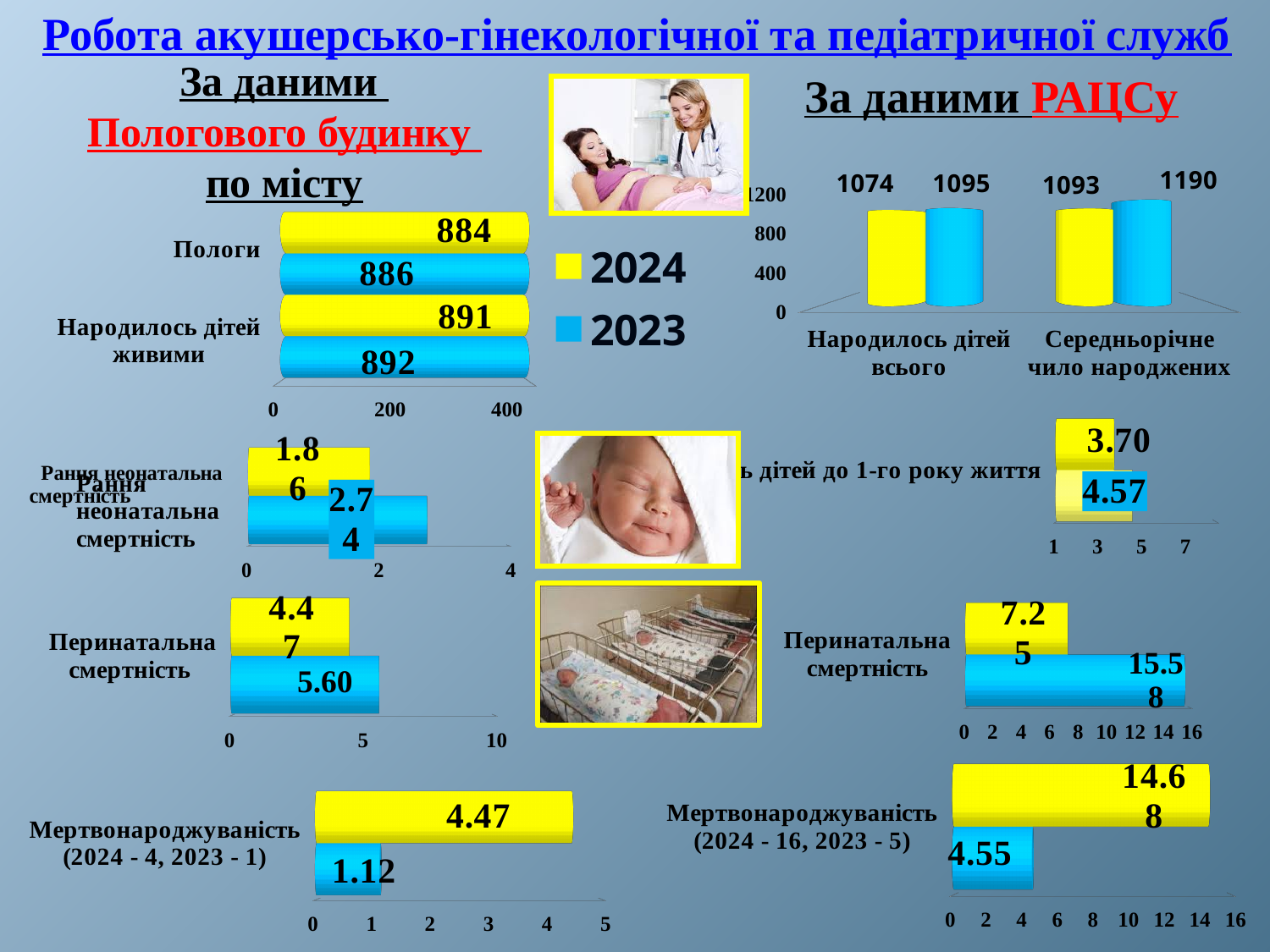
In the РАЦС chart (top right, vertical bars), which bar is the highest? Середньорічне число народжених, 2023 (1190) In the chart for Смертність дітей до 1-го року життя (right side, middle), which year has the larger value, 2024 or 2023? 2023 In the maternity hospital chart (top left), what is the difference between Пологи in 2023 and Пологи in 2024? 2 In the РАЦС chart (top right, vertical bars), what is the difference between Середньорічне число народжених in 2023 and in 2024? 97 In the chart for Смертність дітей до 1-го року життя (right side, middle), what is the value for 2024? 3.70 In the maternity hospital chart (top left), what is the value for Народилось дітей живими in 2023? 892 According to the legend in the centre of the slide, which colour represents 2023? Blue In the РАЦС chart (top right, vertical bars), what is the value for Народилось дітей всього in 2023? 1095 In the Мертвонароджуваність chart on the left (2024 - 4, 2023 - 1), what is the difference between the 2024 and 2023 values? 3.35 In the РАЦС chart (top right, vertical bars), is the value for Народилось дітей всього in 2024 greater or less than 800? greater In the maternity hospital chart (top left, 'Пологи' and 'Народилось дітей живими'), what is the value for Пологи in 2024? 884 In the Перинатальна смертність chart on the left (maternity hospital data), what is the value for 2023? 5.60